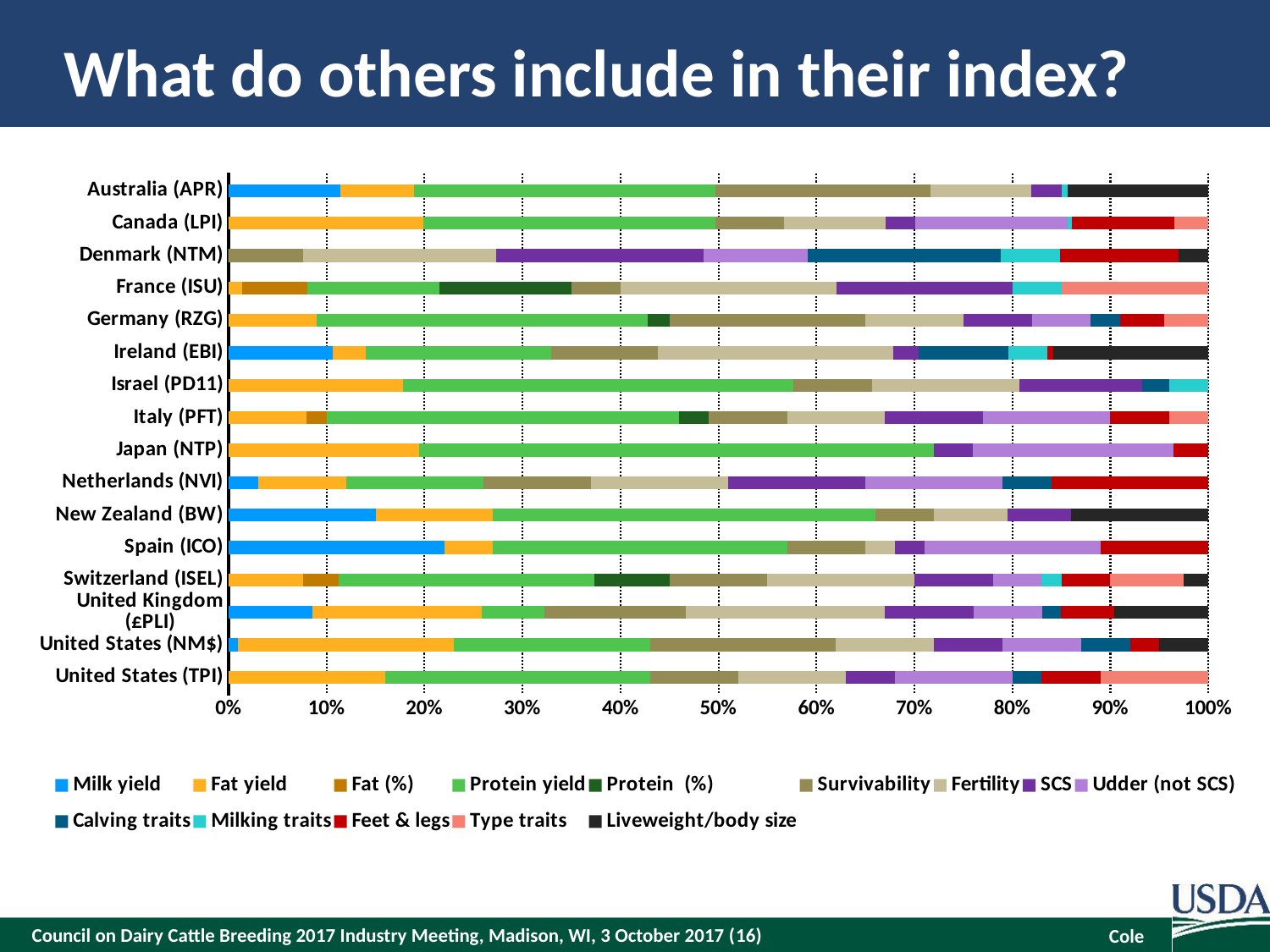
Is the Milk yield share for Spain (ICO) greater or less than 20%? greater What is the maximum value shown on the horizontal axis of the chart? 100% Is the Milk yield share for Australia (APR) greater or less than 20%? less What kind of chart is shown on the slide? Stacked bar chart How many series does the chart legend list? 14 Is the Protein yield share for Japan (NTP) greater or less than 40%? greater What does each stacked bar in the chart total? 100% Which index has the largest Protein yield share? Japan (NTP) What is the title of the slide containing the chart? What do others include in their index? Which index has the larger Milk yield share, Spain (ICO) or New Zealand (BW)? Spain (ICO) Which index has the larger Fat yield share, Canada (LPI) or Australia (APR)? Canada (LPI) How many indices (countries) are listed on the vertical axis of the chart? 16